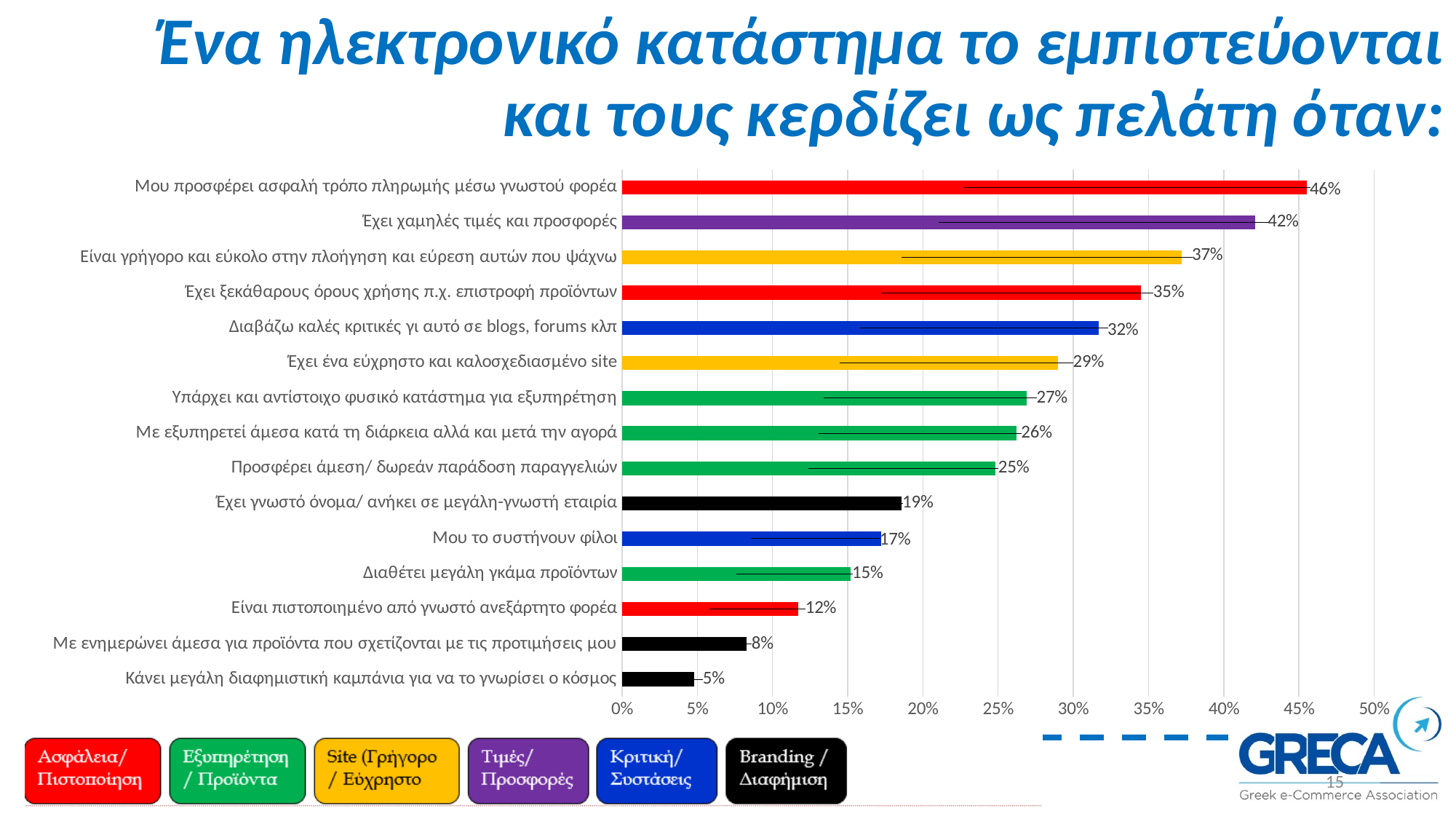
What is the difference between the values for "Έχει χαμηλές τιμές και προσφορές" and "Έχει ξεκάθαρους όρους χρήσης π.χ. επιστροφή προϊόντων"? 7% What colour is the bar for "Έχει χαμηλές τιμές και προσφορές"? Purple Which category has the lowest value? Κάνει μεγάλη διαφημιστική καμπάνια για να το γνωρίσει ο κόσμος How many categories are shown in the chart? 15 Which category has the highest value? Μου προσφέρει ασφαλή τρόπο πληρωμής μέσω γνωστού φορέα How many colour categories does the legend at the bottom of the slide list? 6 Is the value for "Είναι γρήγορο και εύκολο στην πλοήγηση και εύρεση αυτών που ψάχνω" greater or less than 35%? greater What is the value for "Διαβάζω καλές κριτικές γι αυτό σε blogs, forums κλπ"? 32% What is the value for "Μου το συστήνουν φίλοι"? 17% What kind of chart is shown on the slide? Bar chart What is the value for "Μου προσφέρει ασφαλή τρόπο πληρωμής μέσω γνωστού φορέα"? 46% Which is larger: the value for "Έχει γνωστό όνομα/ ανήκει σε μεγάλη-γνωστή εταιρία" or the value for "Διαθέτει μεγάλη γκάμα προϊόντων"? Έχει γνωστό όνομα/ ανήκει σε μεγάλη-γνωστή εταιρία